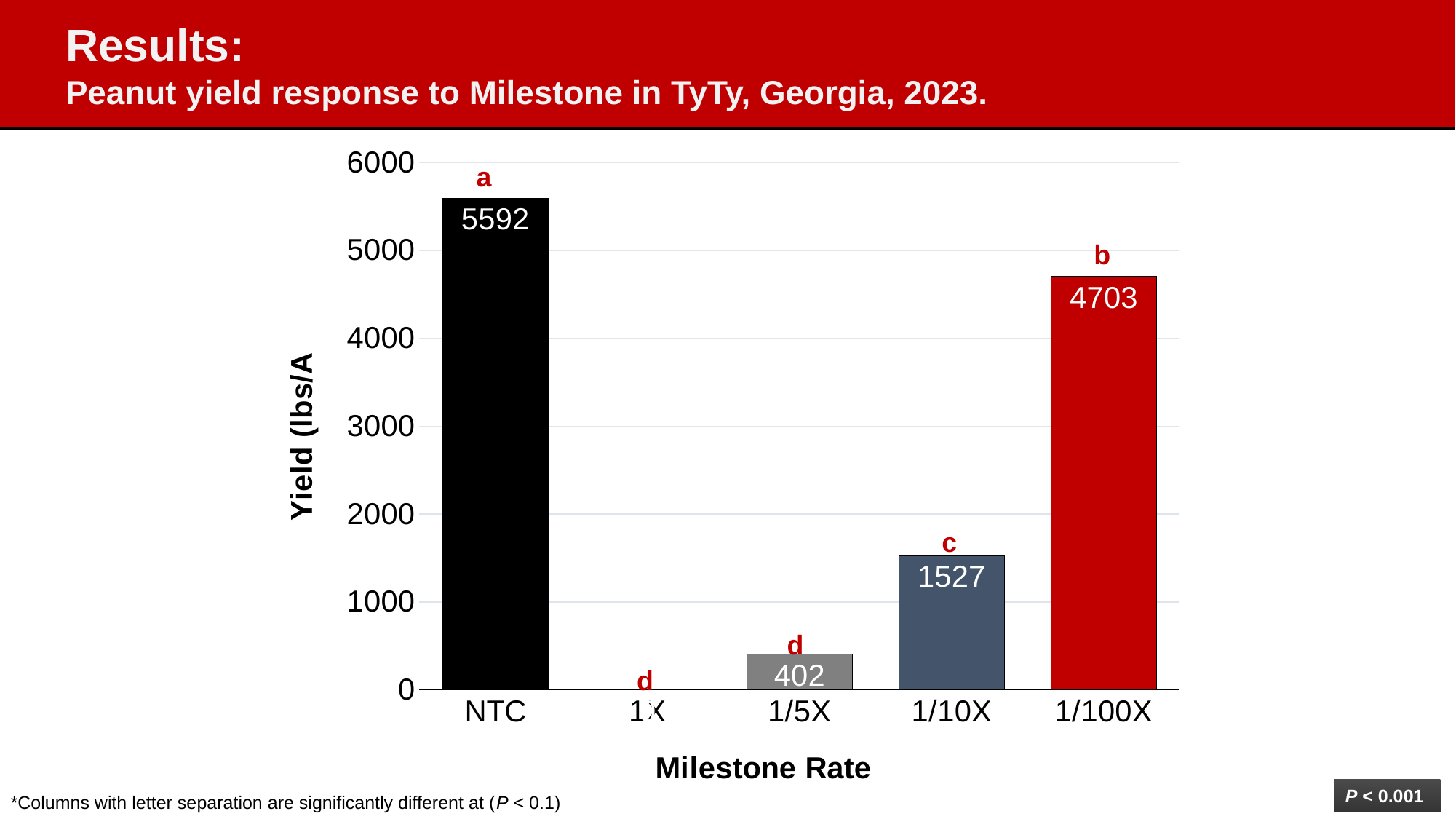
Which Milestone rate has the lowest yield? 1X Which Milestone rate has the highest yield? NTC What is the label of the y axis? Yield (lbs/A) What is the yield for the 1/5X Milestone rate? 402 What is the yield for the 1/10X Milestone rate? 1527 What kind of chart is shown on the slide? Bar chart How many Milestone rate categories are shown on the x axis? 5 What is the difference in yield between NTC and 1/100X? 889 What is the yield for NTC? 5592 What is the difference in yield between 1/10X and 1/5X? 1125 What is the yield for the 1/100X Milestone rate? 4703 Which has a higher yield, 1/10X or 1/100X? 1/100X